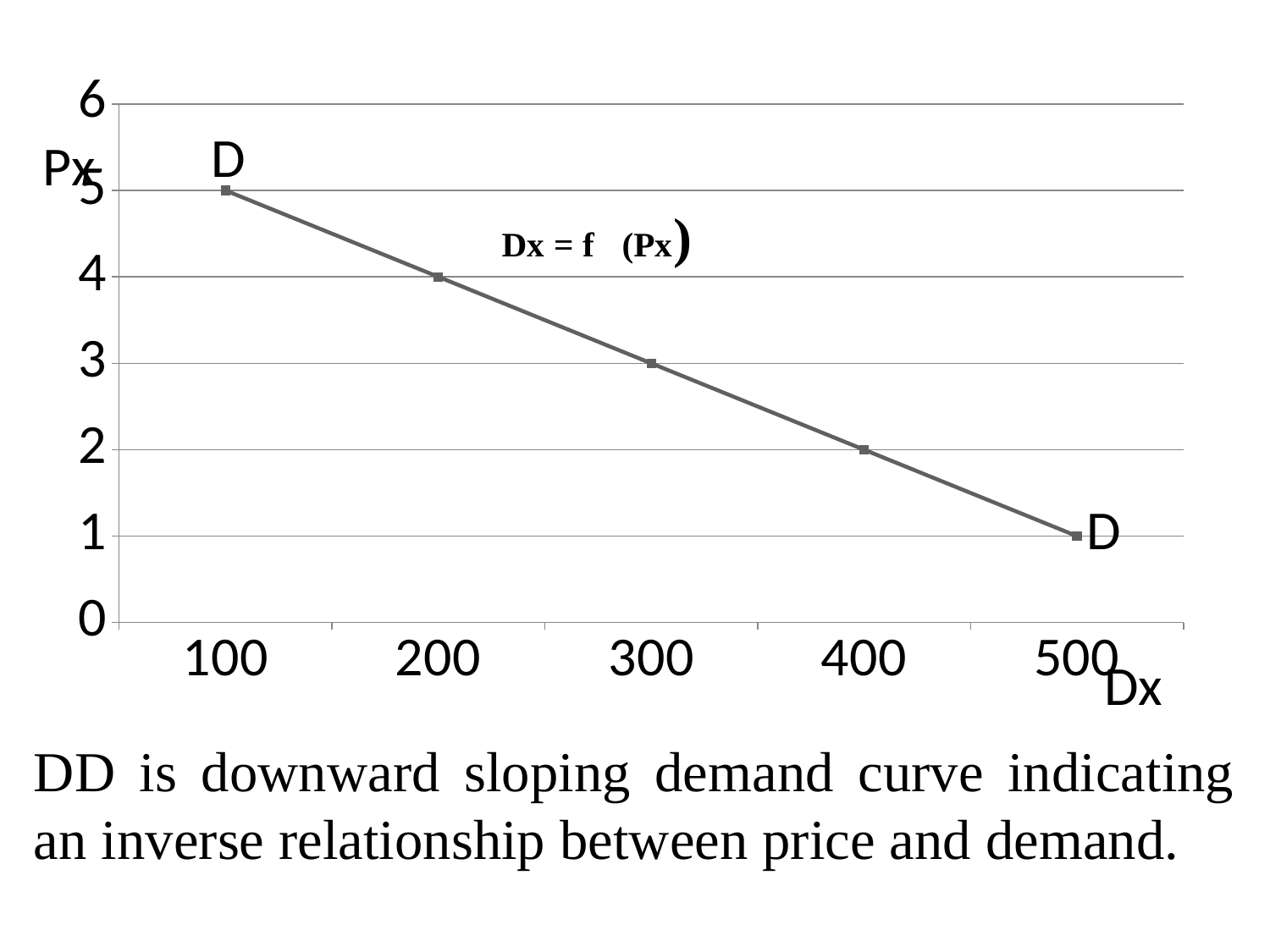
What is the value of Px when Dx is 500? 1 Do the Px values rise or fall as Dx increases along the x axis? fall At which Dx value is Px highest? 100 What is the value of Px when Dx is 300? 3 How many data points are plotted on the line? 5 What equation is written next to the line on the chart? Dx = f (Px) What kind of chart is shown on the slide? line chart What is the value of Px when Dx is 100? 5 What is the difference in Px between Dx = 100 and Dx = 500? 4 Which has a higher Px value: Dx = 200 or Dx = 400? Dx = 200 At which Dx value is Px lowest? 500 What label is shown on the vertical axis of the chart? Px